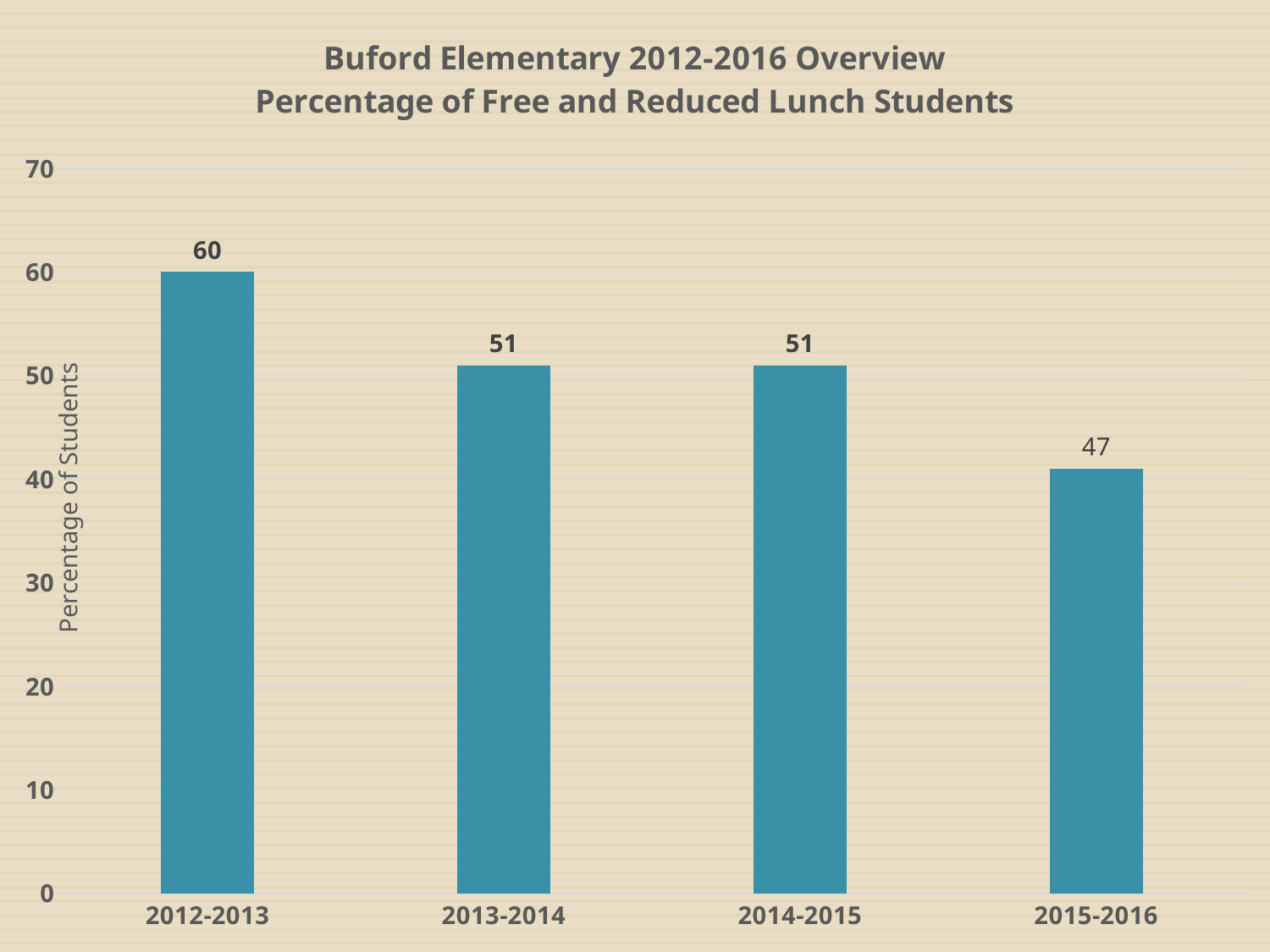
How many years are shown on the x axis? 4 What is the value for 2013-2014? 51 What is the label of the vertical axis? Percentage of Students Which is larger, the value for 2012-2013 or the value for 2014-2015? 2012-2013 Which year has the lowest percentage of free and reduced lunch students? 2015-2016 Is the value for 2015-2016 greater or less than 50? less What is the difference between the values for 2014-2015 and 2015-2016? 4 What is the value for 2012-2013? 60 What kind of chart is shown on the slide? bar chart What is the value for 2015-2016? 47 Which year has the highest percentage of free and reduced lunch students? 2012-2013 What is the difference between the values for 2012-2013 and 2013-2014? 9